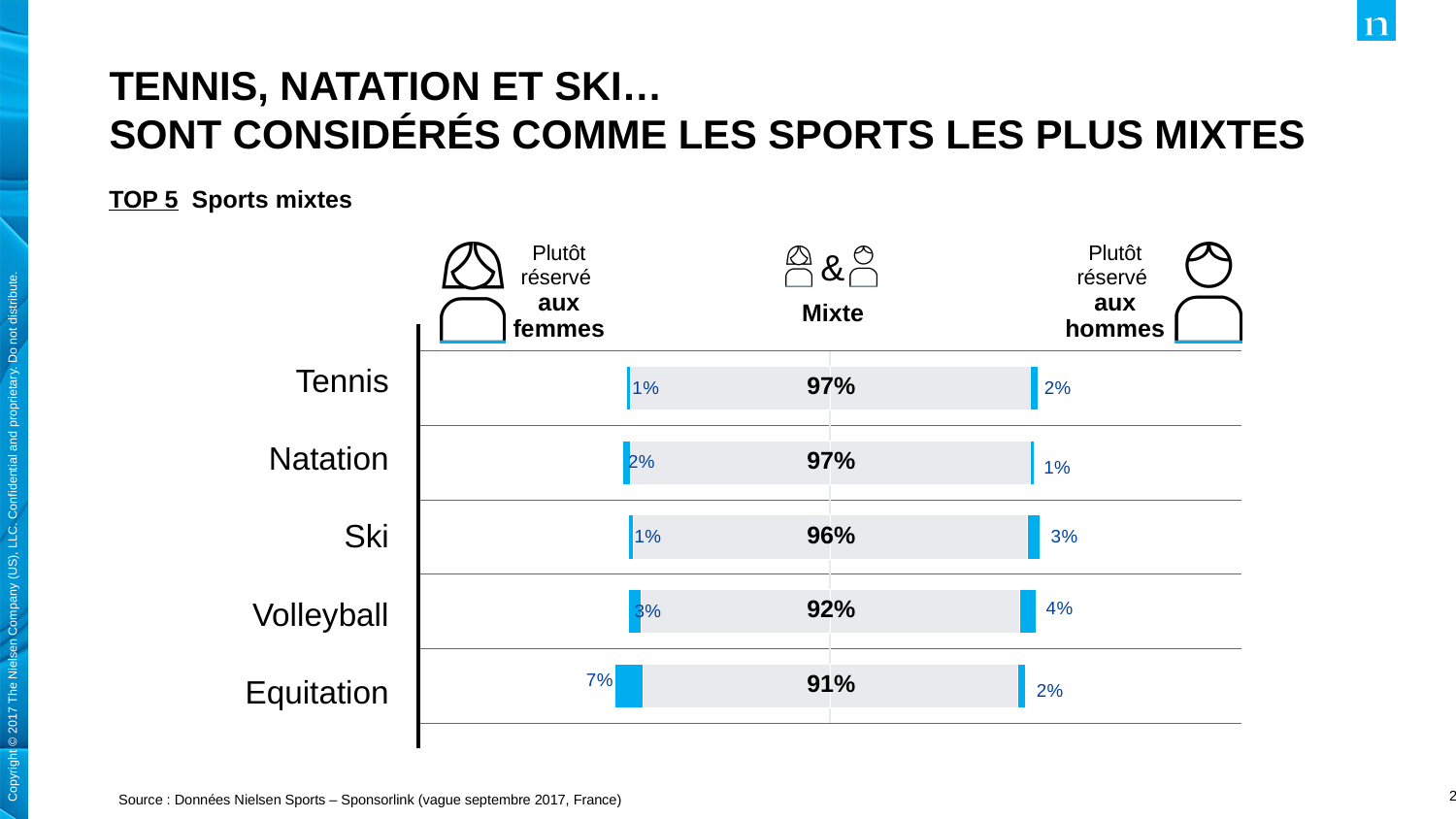
Which sport has the lowest Mixte value? Equitation How many sports are shown in the chart? 5 What is the 'Plutôt réservé aux hommes' value for Volleyball? 4% What is the difference between the Mixte values for Tennis and Equitation? 6% Which is larger, the Mixte value for Volleyball or for Natation? Natation What kind of chart is this? Stacked bar chart What is the Mixte value for Ski? 96% What is the 'Plutôt réservé aux femmes' value for Equitation? 7% Which sport has the highest 'Plutôt réservé aux femmes' value? Equitation Which sport has the highest 'Plutôt réservé aux hommes' value? Volleyball How many series does the chart show? 3 What is the Mixte value for Tennis? 97%